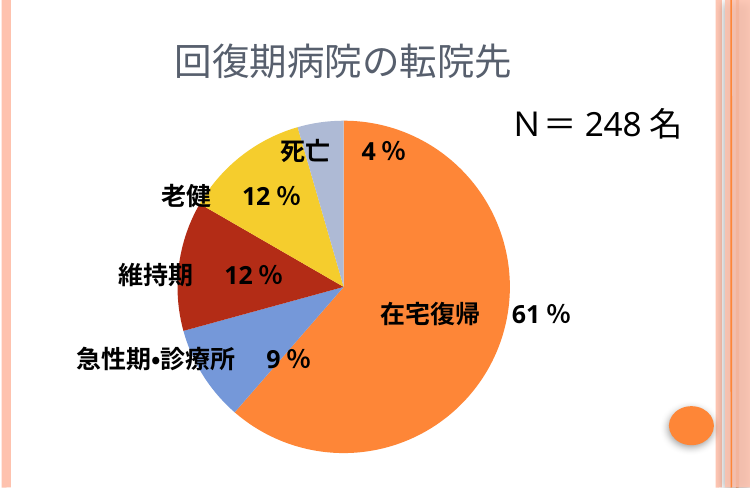
Which category has the smallest share of the pie? 死亡 Which category has the largest share of the pie? 在宅復帰 What share of the pie is 在宅復帰? 61 % What percentage is shown for 維持期? 12 % What is the difference in percentage points between 在宅復帰 and 急性期・診療所? 52 What percentage is shown for 老健? 12 % How many slices does the pie chart have? 5 What is the sample size (N) shown on the slide? 248 名 What is the title of the chart? 回復期病院の転院先 What kind of chart is shown on the slide? pie chart What percentage is shown for 急性期・診療所? 9 % What percentage is shown for 死亡? 4 %